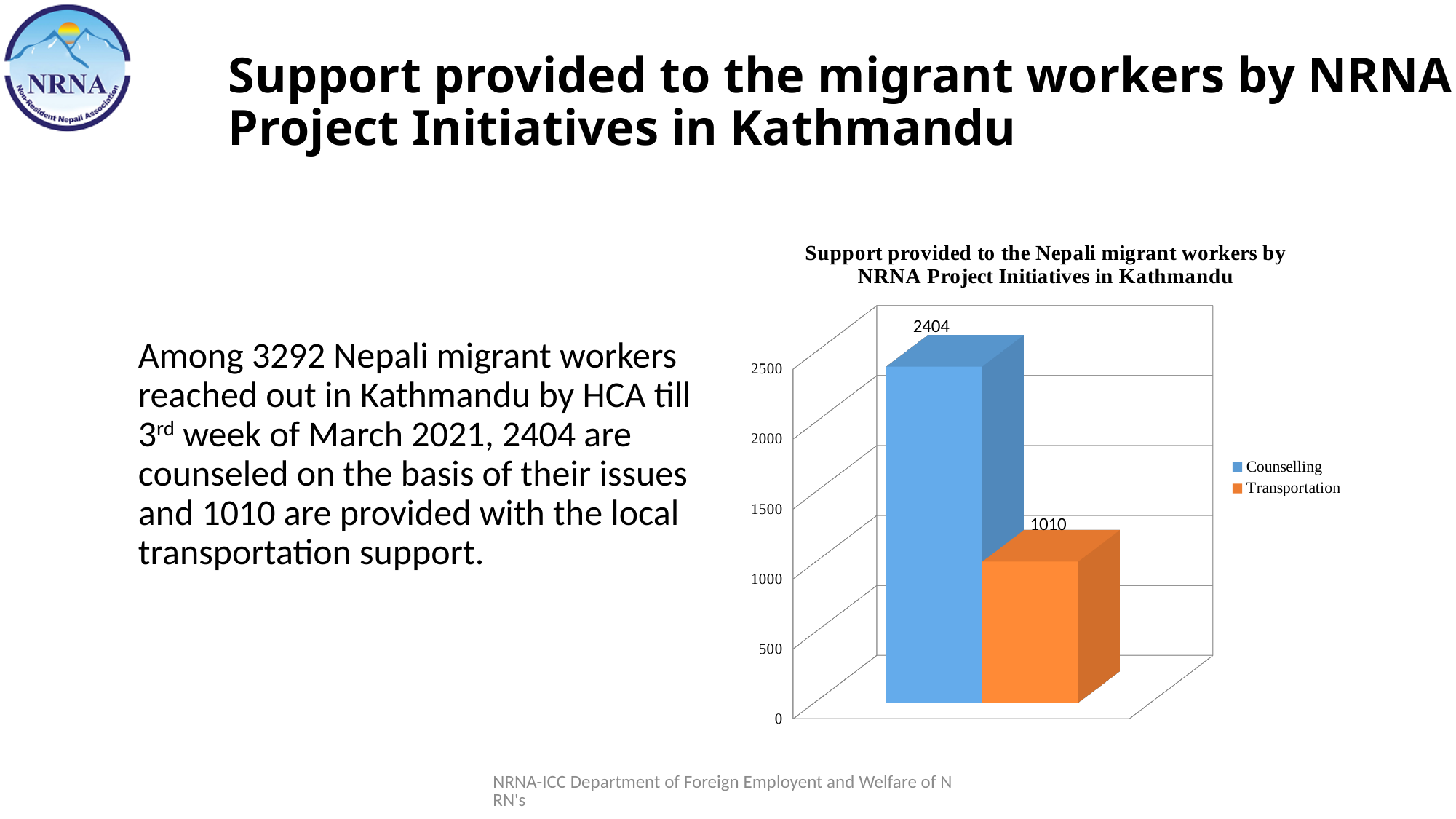
Which series has the lowest value? Transportation Is the value for Counselling greater or less than 2000? greater Which is larger, Counselling or Transportation? Counselling What kind of chart is shown? bar chart What is the difference between the Counselling and Transportation values? 1394 Is the value for Transportation greater or less than 1500? less What is the value for Transportation? 1010 How many series does the legend list? 2 What is the value for Counselling? 2404 Which series has the highest value? Counselling What is the title of the chart? Support provided to the Nepali migrant workers by NRNA Project Initiatives in Kathmandu What colour is the Transportation bar? orange